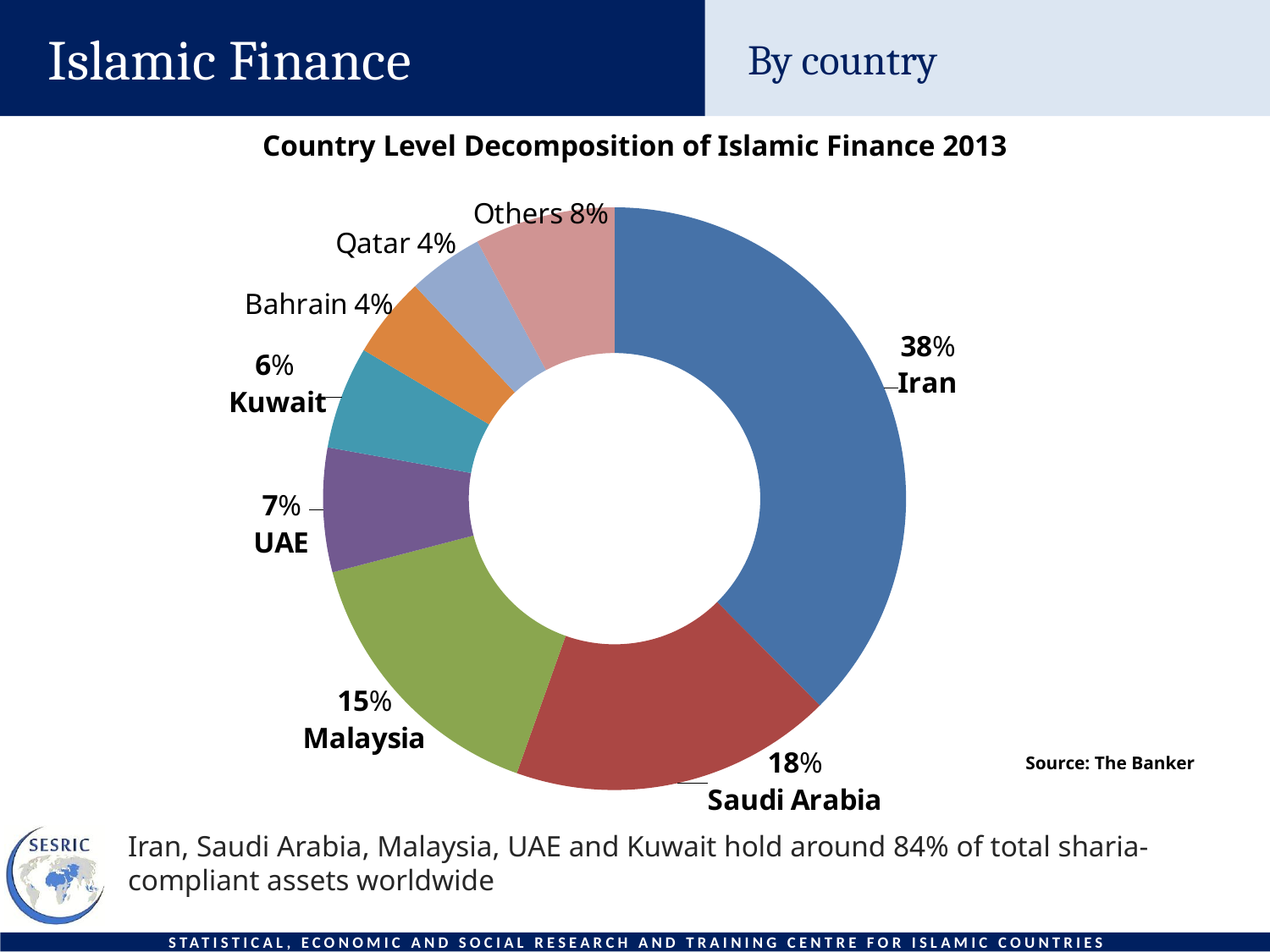
Which is larger, the share for UAE or the share for Kuwait? UAE What is the value shown for Kuwait? 6% How many categories are shown in the chart? 8 What kind of chart is shown on the slide? Pie chart (doughnut) Which category has the smallest share, excluding ties? Name the two categories tied for the smallest share. Bahrain and Qatar What share of Islamic finance does Iran hold in the chart? 38% What is the title of the chart? Country Level Decomposition of Islamic Finance 2013 What is the difference between Malaysia's share and UAE's share? 8% What is the value shown for Saudi Arabia? 18% What is the difference between Iran's share and Saudi Arabia's share? 20% Which country has the largest share in the chart? Iran What percentage is shown for Malaysia? 15%